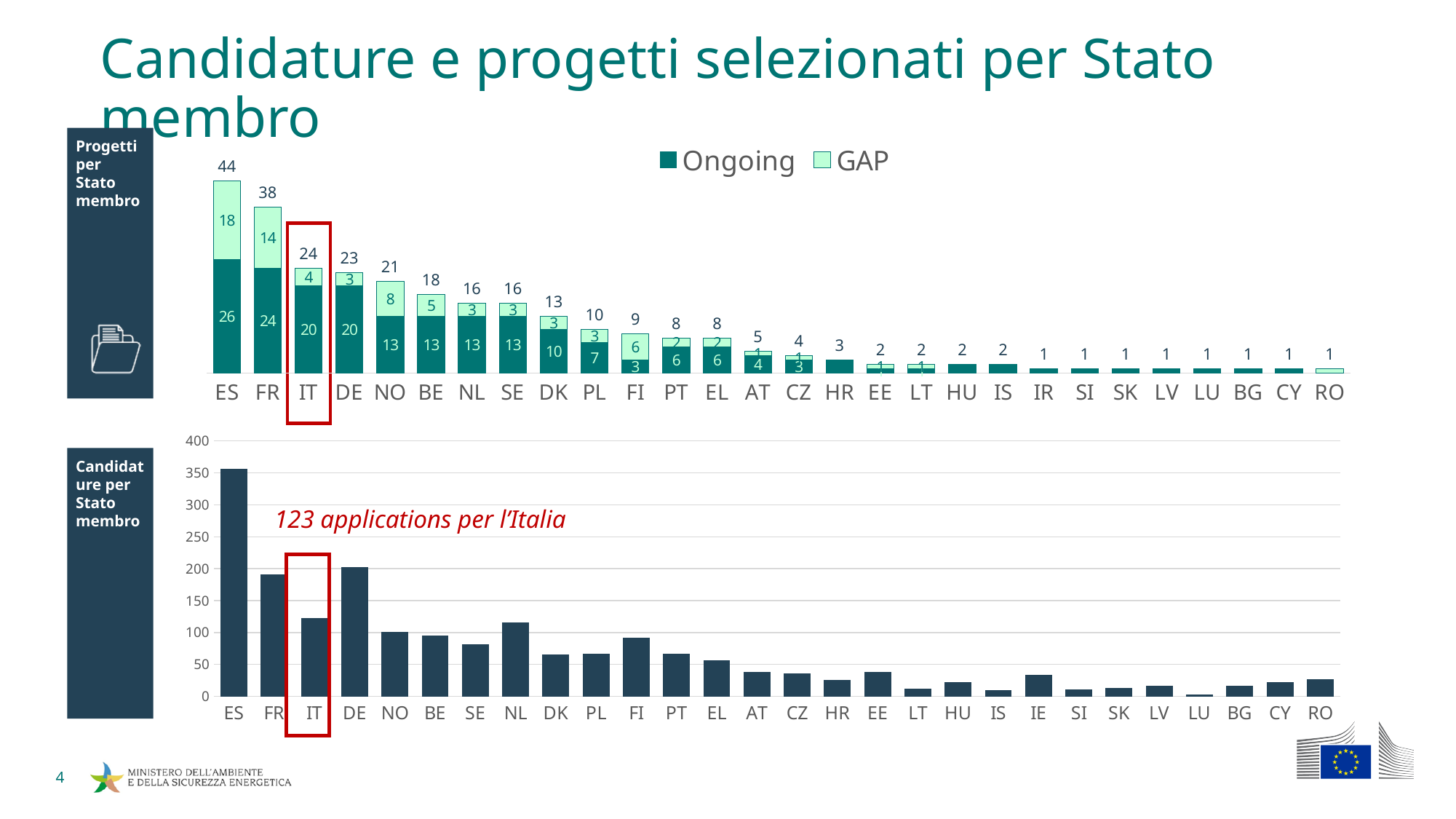
In the top chart (Progetti per Stato membro), what is the difference between the totals for ES and FR? 6 What kind of chart is the bottom chart (Candidature per Stato membro)? Bar chart In the top chart (Progetti per Stato membro), what is the Ongoing value for IT? 20 In the bottom chart (Candidature per Stato membro), how many applications does the annotation give for Italy? 123 In the top chart (Progetti per Stato membro), which is larger, the GAP value for FI or the Ongoing value for FI? GAP In the bottom chart (Candidature per Stato membro), is the value for ES greater or less than 300? greater In the top chart (Progetti per Stato membro), how many series does the legend list? 2 In the top chart (Progetti per Stato membro), which Member State has the highest total? ES In the top chart (Progetti per Stato membro), what is the total number of projects for ES? 44 In the top chart (Progetti per Stato membro), what is the total of the stacked bar for FI? 9 In the top chart (Progetti per Stato membro), what is the GAP value for NO? 8 In the bottom chart (Candidature per Stato membro), which Member State has the highest number of applications? ES